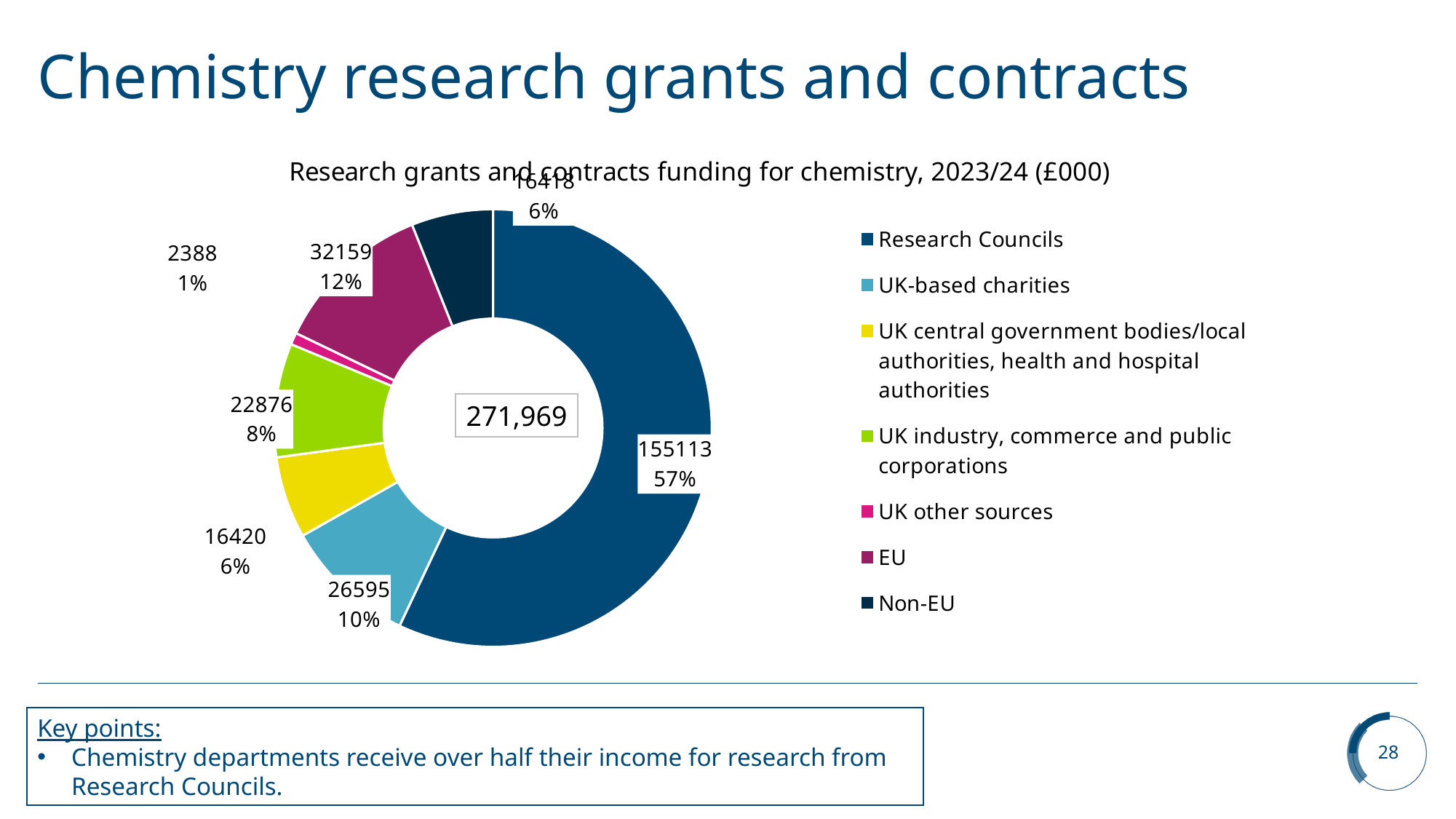
What is the funding value for UK-based charities? 26595 Which funding source has the largest share? Research Councils What is the difference between the EU funding value and the UK-based charities funding value? 5564 Which funding source has the smallest share? UK other sources What is the total funding shown in the centre of the chart? 271,969 What percentage share of funding comes from the EU? 12% What type of chart is shown on the slide? Doughnut (pie) chart What is the funding value for Research Councils? 155113 Which is larger: funding from the EU or funding from UK industry, commerce and public corporations? EU What percentage share of funding comes from UK central government bodies/local authorities, health and hospital authorities? 6% What is the funding value for UK industry, commerce and public corporations? 22876 How many funding sources does the legend list? 7